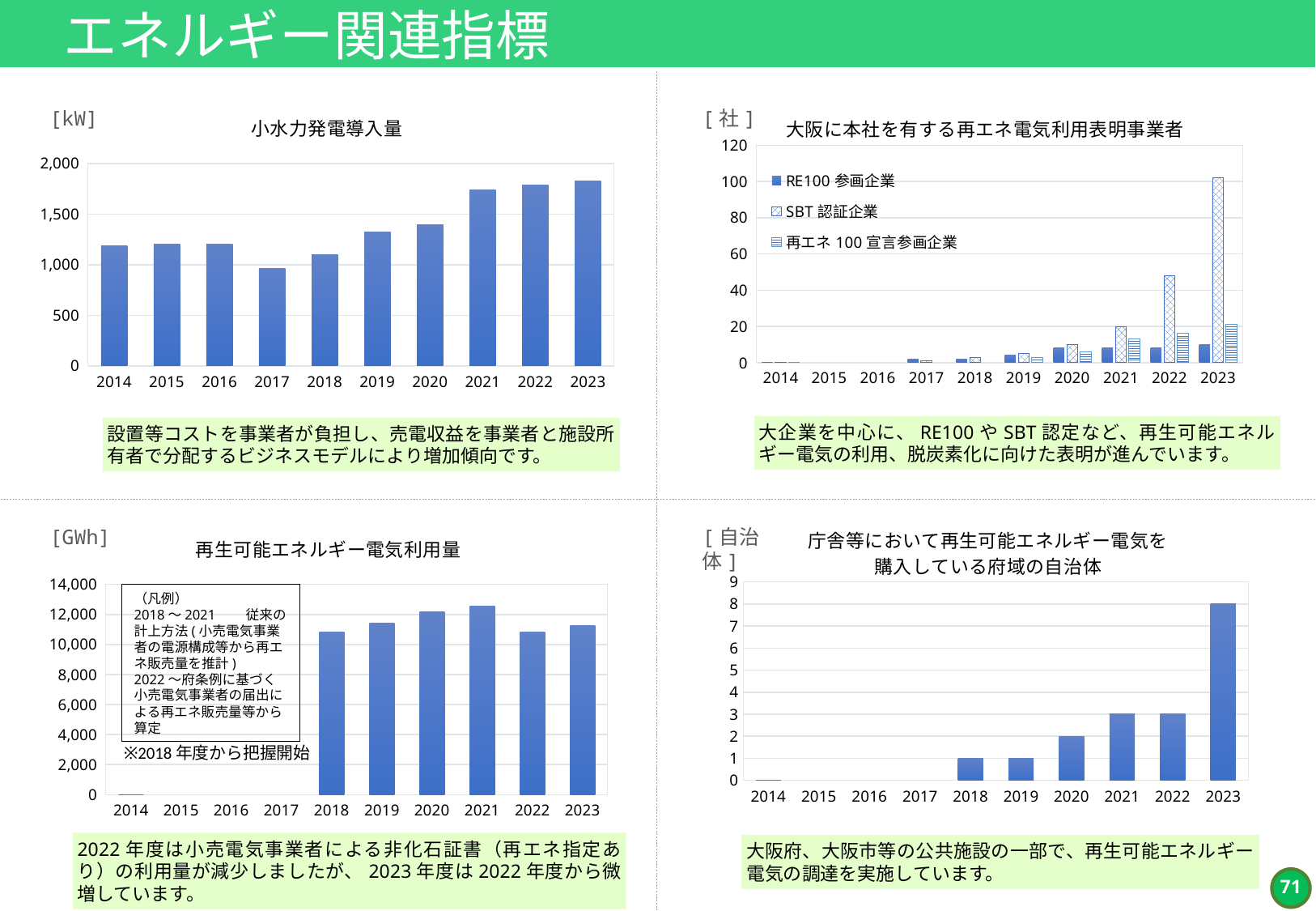
In the chart titled 小水力発電導入量, is the value for 2021 greater or less than 1,500? greater In the chart titled 大阪に本社を有する再エネ電気利用表明事業者, which series has the highest value in 2023? SBT認証企業 In the chart titled 小水力発電導入量, what unit is shown on the axis label? kW In the chart titled 庁舎等において再生可能エネルギー電気を購入している府域の自治体, what is the value for 2023? 8 In the chart titled 再生可能エネルギー電気利用量, which year has the highest value? 2021 In the chart titled 再生可能エネルギー電気利用量, is the value for 2018 greater or less than 12,000? less In the chart titled 庁舎等において再生可能エネルギー電気を購入している府域の自治体, what is the difference between the values for 2023 and 2022? 5 In the chart titled 小水力発電導入量, which year has the lowest value? 2017 In the chart titled 大阪に本社を有する再エネ電気利用表明事業者, how many series does the legend list? 3 What kind of chart is the chart titled 庁舎等において再生可能エネルギー電気を購入している府域の自治体? bar chart In the chart titled 小水力発電導入量, is the value for 2017 greater or less than 1,000? less